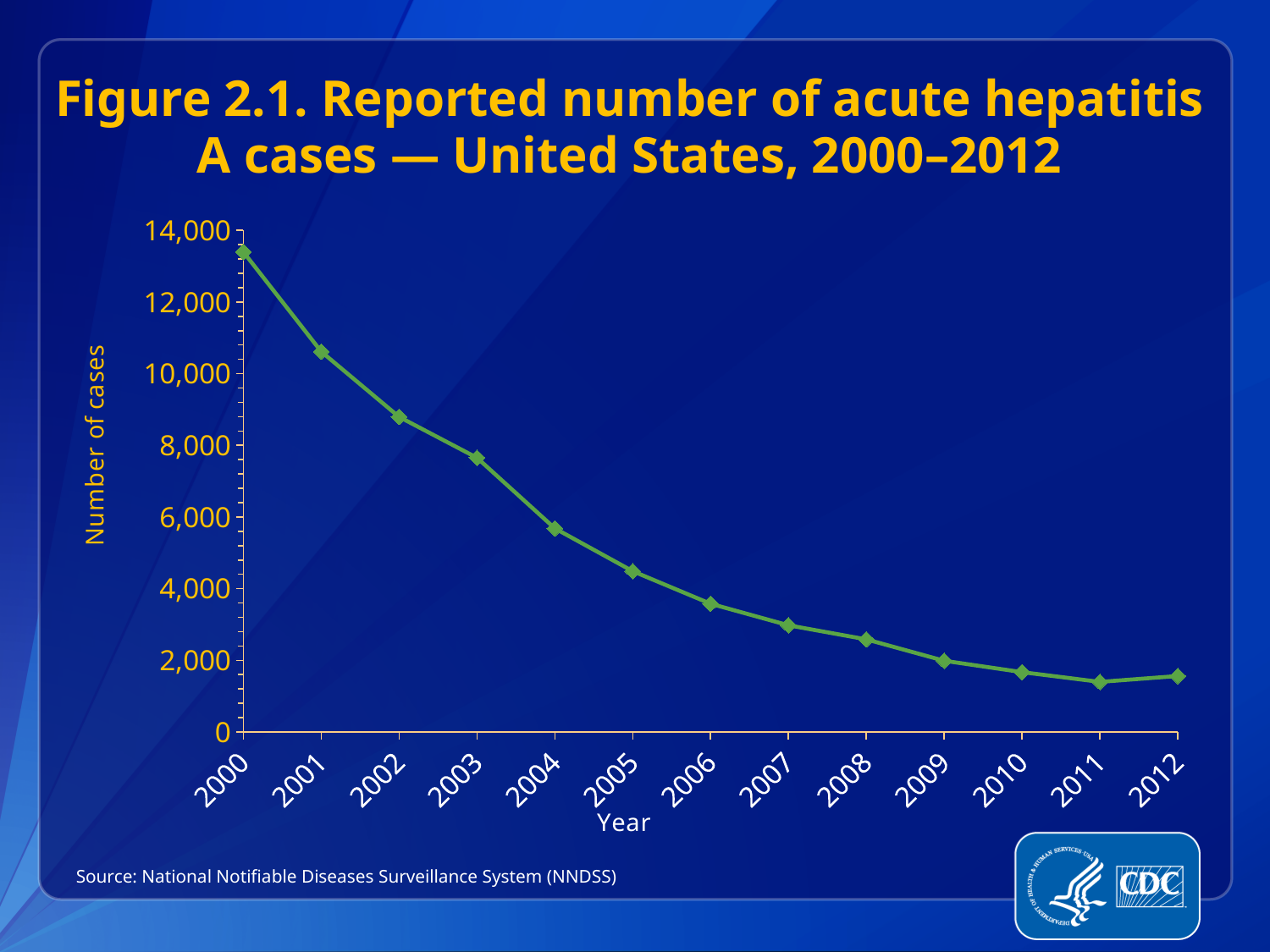
Which year had more reported cases, 2002 or 2005? 2002 Is the number of cases in 2011 greater or less than 2,000? less Which year has the highest reported number of acute hepatitis A cases? 2000 Is the number of cases in 2002 greater or less than 10,000? less Is the number of cases in 2001 greater or less than 10,000? greater What kind of chart is shown on the slide? line chart How many years (data points) are plotted on the chart? 13 Do the reported numbers of acute hepatitis A cases generally rise or fall from 2000 to 2012? fall What is the label of the vertical axis? Number of cases